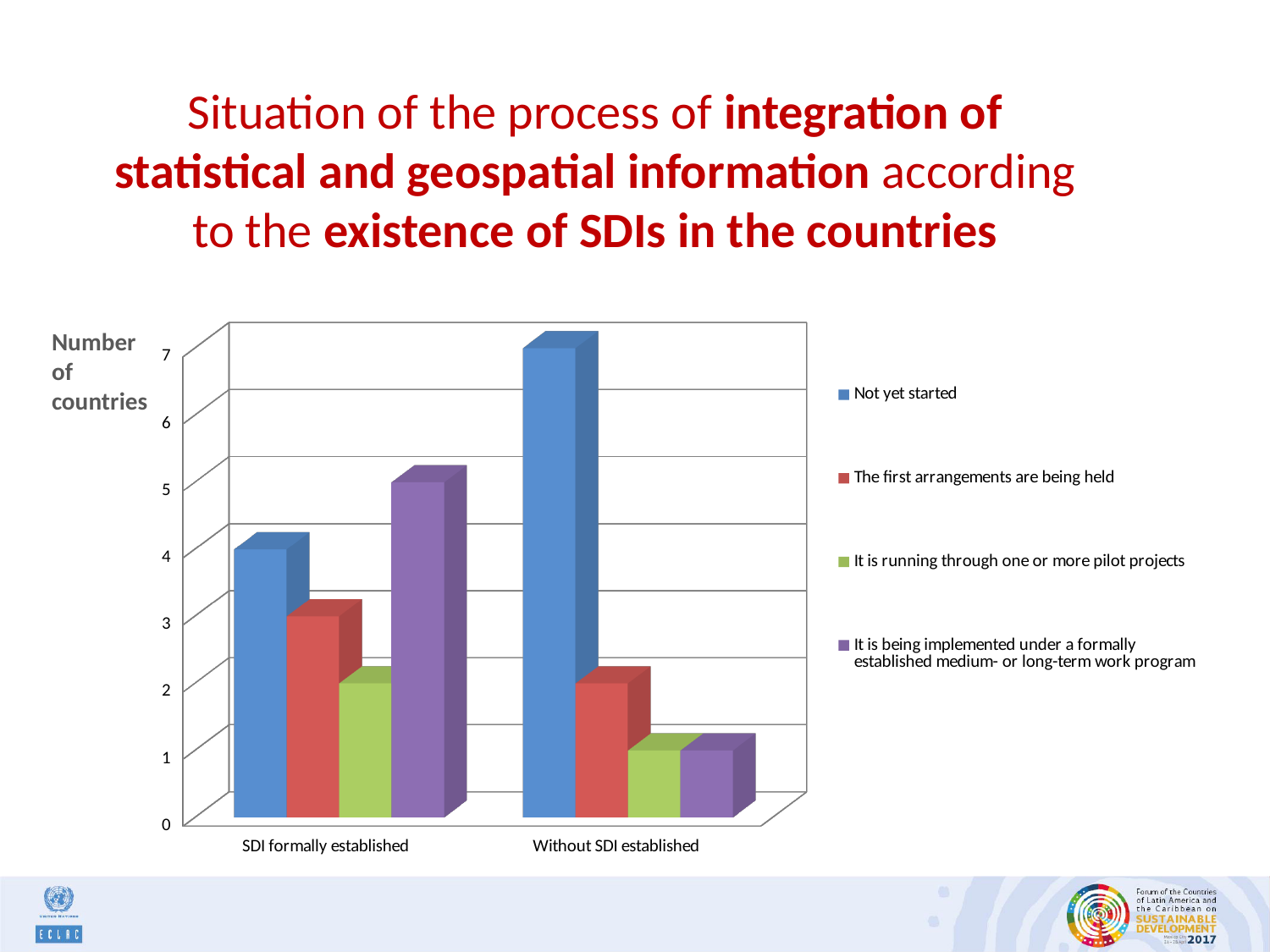
What kind of chart is shown on the slide? bar chart What is the difference between the 'Not yet started' values for 'Without SDI established' and 'SDI formally established'? 3 What is the number of countries for 'Not yet started' in the 'Without SDI established' category? 7 What is the number of countries for 'It is being implemented under a formally established medium- or long-term work program' in the 'SDI formally established' category? 5 Which series has the lowest value in the 'SDI formally established' category? It is running through one or more pilot projects How many categories are shown on the x axis? 2 Which is larger: 'The first arrangements are being held' for 'SDI formally established' or for 'Without SDI established'? SDI formally established Which series has the highest value in the 'Without SDI established' category? Not yet started What is the label of the vertical axis? Number of countries What is the number of countries for 'The first arrangements are being held' in the 'Without SDI established' category? 2 What is the number of countries for 'Not yet started' in the 'SDI formally established' category? 4 How many series does the legend list? 4